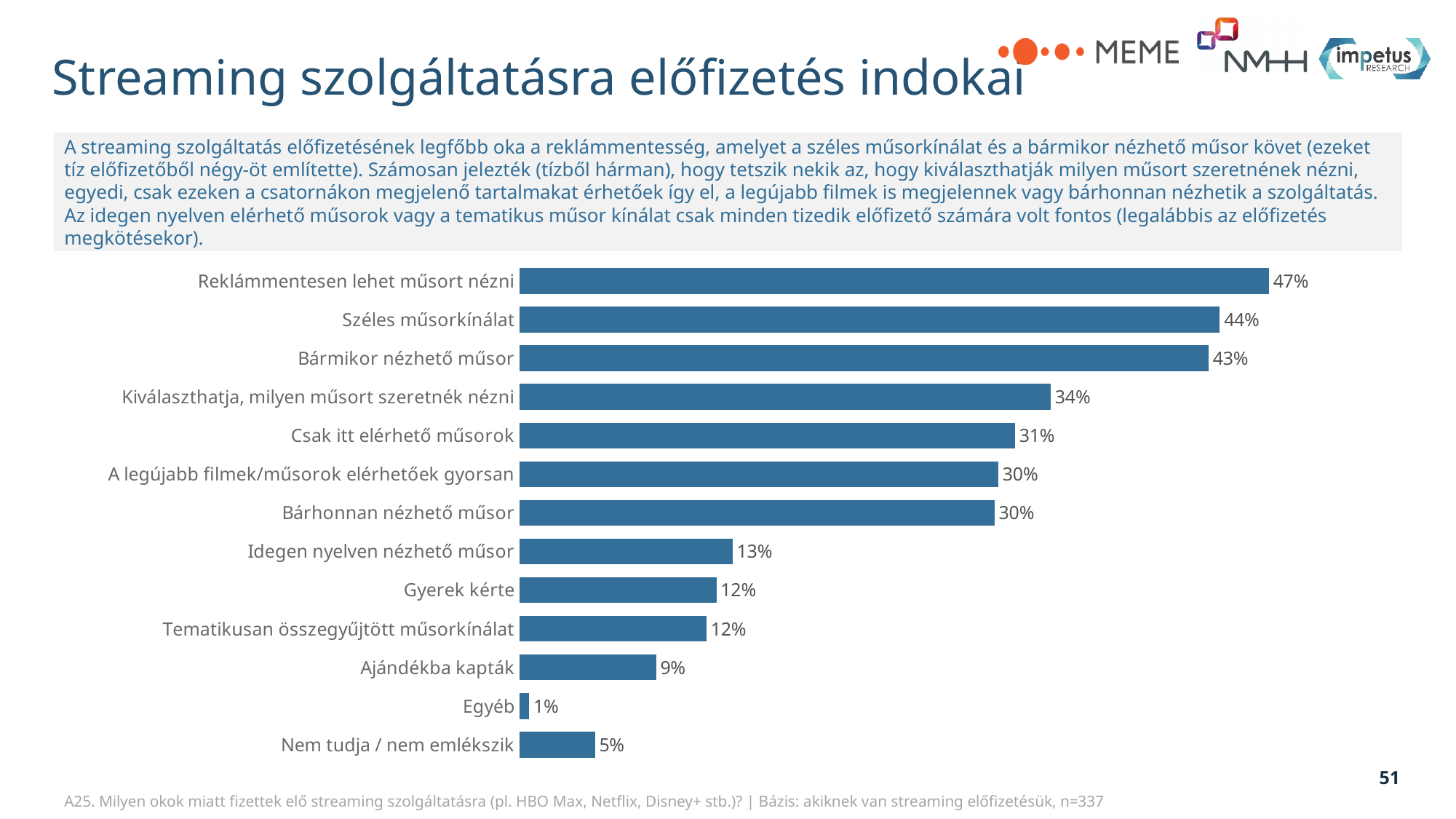
What is the value for "Ajándékba kapták"? 9% What is the difference between "Kiválaszthatja, milyen műsort szeretnék nézni" and "Gyerek kérte"? 22% How many categories are shown in the chart? 13 What is the difference between "Széles műsorkínálat" and "Bármikor nézhető műsor"? 1% What kind of chart is shown on the slide? Bar chart What is the title of the slide? Streaming szolgáltatásra előfizetés indokai Which category has the lowest value? Egyéb Which is larger: "Csak itt elérhető műsorok" or "Tematikusan összegyűjtött műsorkínálat"? Csak itt elérhető műsorok What is the value for "Idegen nyelven nézhető műsor"? 13% Which category has the highest value? Reklámmentesen lehet műsort nézni What is the value for "Reklámmentesen lehet műsort nézni"? 47% What is the value for "Nem tudja / nem emlékszik"? 5%